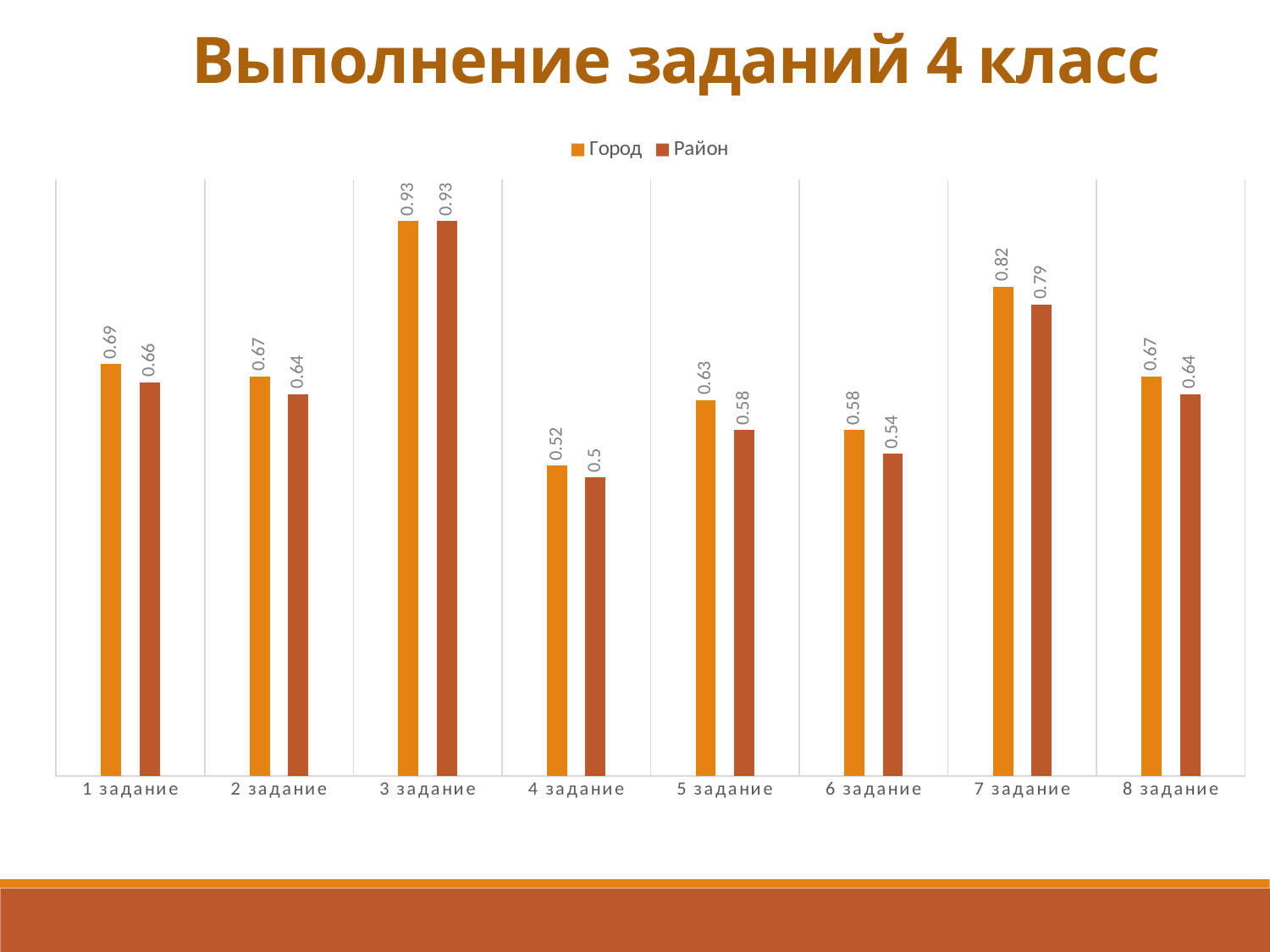
What is the value for Город on 3 задание? 0.93 What is the value for Район on 1 задание? 0.66 What is the difference between Город and Район on 6 задание? 0.04 How many series does the legend list? 2 Which task has the highest value for Город? 3 задание How many tasks are shown on the x axis? 8 What is the value for Район on 4 задание? 0.5 Which is larger on 5 задание, Город or Район? Город What is the title of the slide? Выполнение заданий 4 класс Which task has the lowest value for Район? 4 задание What is the value for Город on 7 задание? 0.82 What kind of chart is shown on the slide? Bar chart